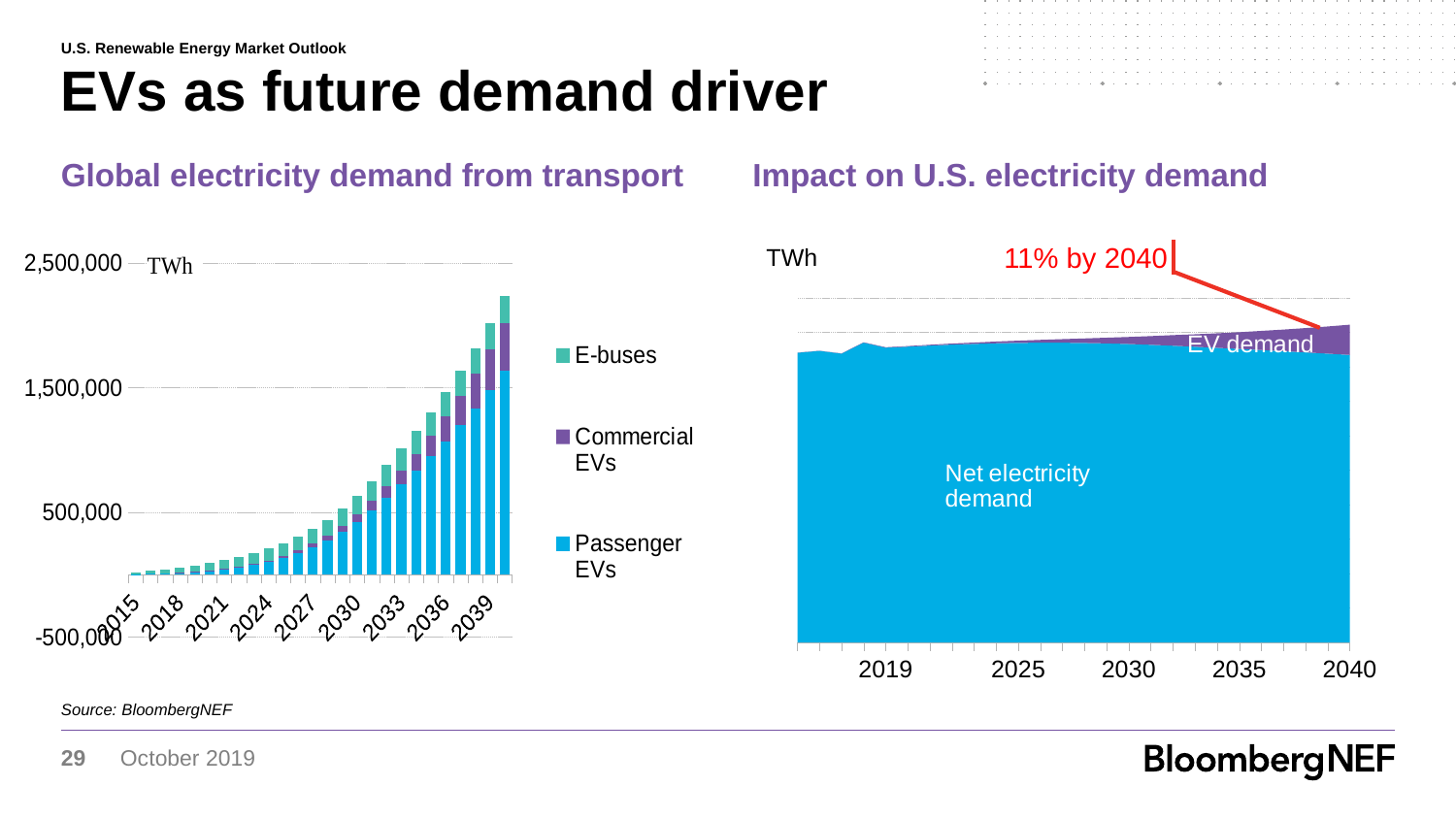
In the 'Global electricity demand from transport' chart, is the total for 2033 greater or less than 500,000? greater How many series does the legend of the 'Global electricity demand from transport' chart list? 3 In the 'Global electricity demand from transport' chart, do the stacked bar totals rise or fall from 2015 to 2039? Rise What kind of chart is the 'Global electricity demand from transport' chart? Stacked bar chart What kind of chart is the 'Impact on U.S. electricity demand' chart? Stacked area chart In the 'Global electricity demand from transport' chart, what are the three series in the legend? E-buses, Commercial EVs, Passenger EVs How many year labels are shown on the x axis of the 'Global electricity demand from transport' chart? 9 In the 'Impact on U.S. electricity demand' chart, which is larger in 2040, Net electricity demand or EV demand? Net electricity demand What share of U.S. electricity demand does the annotation on the 'Impact on U.S. electricity demand' chart attribute to EV demand by 2040? 11% In the 'Global electricity demand from transport' chart, is the total for 2027 greater or less than 500,000? less In the 'Global electricity demand from transport' chart, which series makes up the largest part of the 2039 bar, Passenger EVs or E-buses? Passenger EVs In the 'Global electricity demand from transport' chart, is the total for 2039 greater or less than 1,500,000? greater